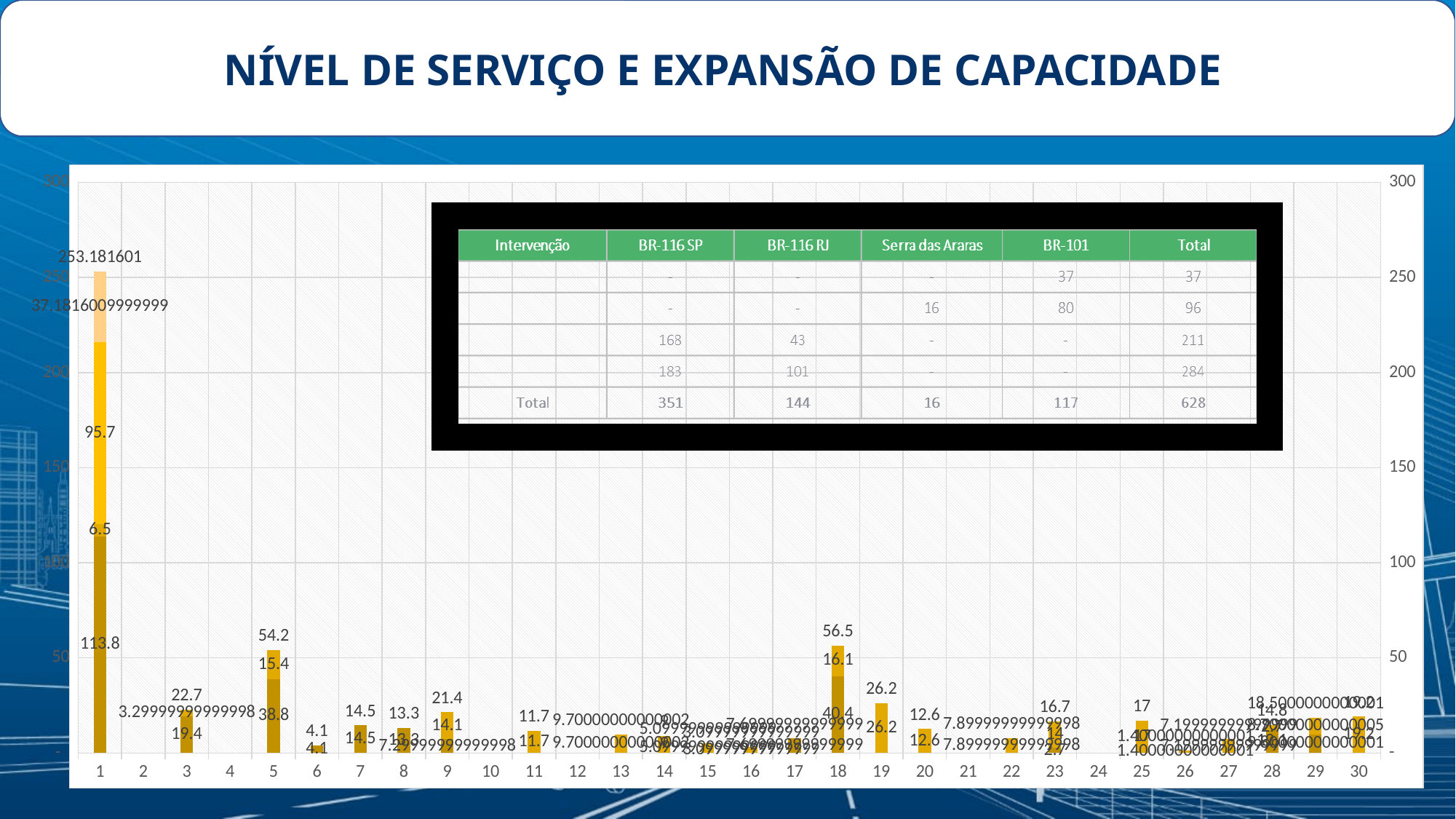
Is the total value of the bar for category 19 greater or less than 50? less What is the difference between the total for category 18 (56.5) and the total for category 5 (54.2)? 2.3 What is the value of the bottom segment of the bar for category 1? 113.8 What is the value of the bottom segment of the bar for category 18? 40.4 Is the total value of the bar for category 1 greater or less than 200? greater Which category has the tallest stacked bar in the chart? 1 Which stacked bar is taller, category 5 or category 18? 18 How many categories are shown along the x axis of the chart? 30 What is the total value labelled at the top of the stacked bar for category 1? 253.181601 What is the total value labelled at the top of the stacked bar for category 5? 54.2 What is the total value labelled at the top of the stacked bar for category 18? 56.5 What type of chart is shown on the slide? bar chart